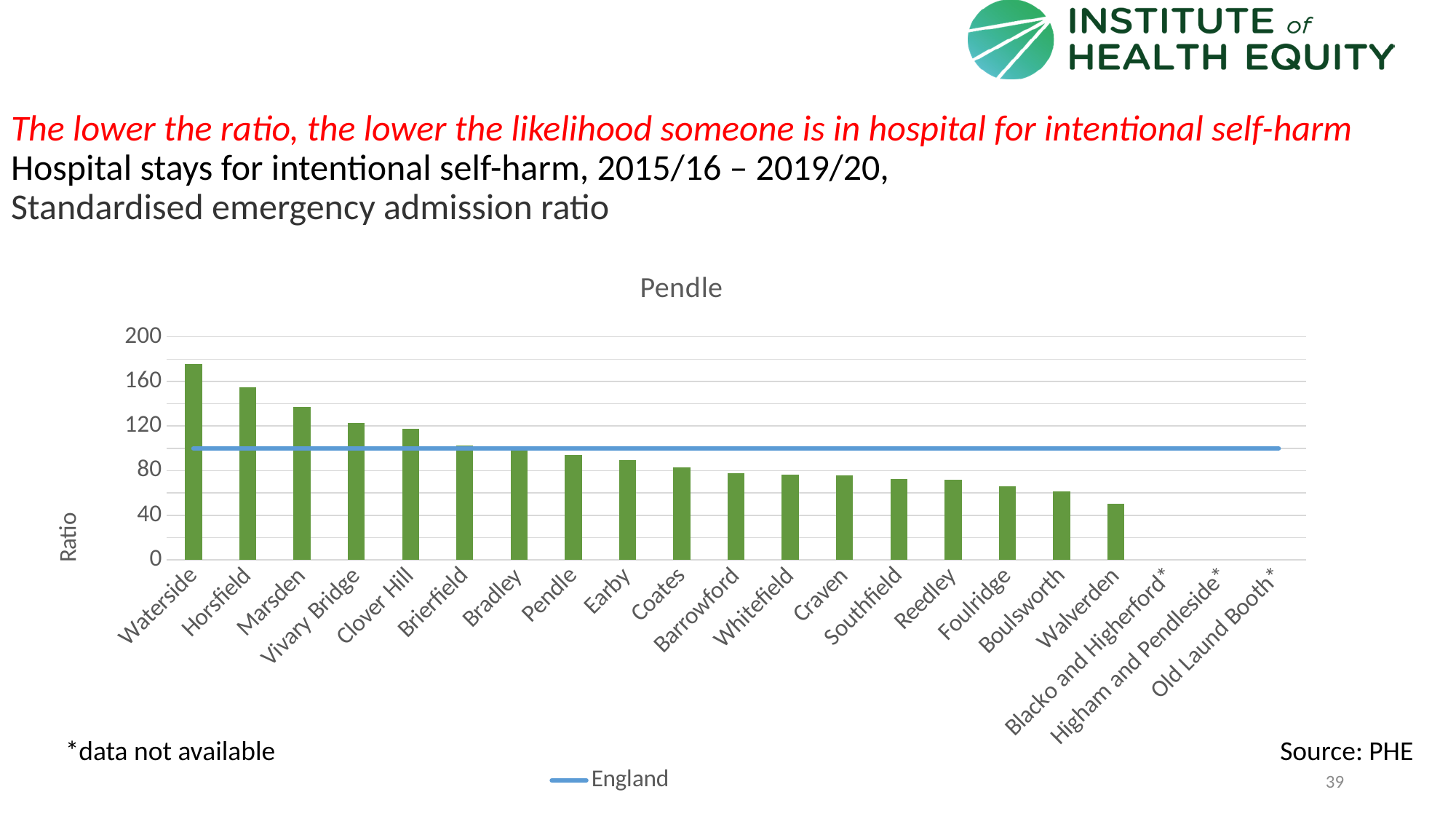
What kind of chart is shown on the slide? combination bar and line chart How many areas are marked with an asterisk as data not available? 3 Is the value for Waterside greater or less than 160? greater Is the value for Foulridge greater or less than 80? less Is the value for Earby greater or less than 100? less Which area with a plotted bar has the lowest ratio? Walverden Do the bar values rise or fall from left to right along the x axis? fall How many areas are listed on the x axis of the chart? 21 Which area has the highest ratio in the Pendle chart? Waterside Which has the larger ratio, Horsfield or Marsden? Horsfield